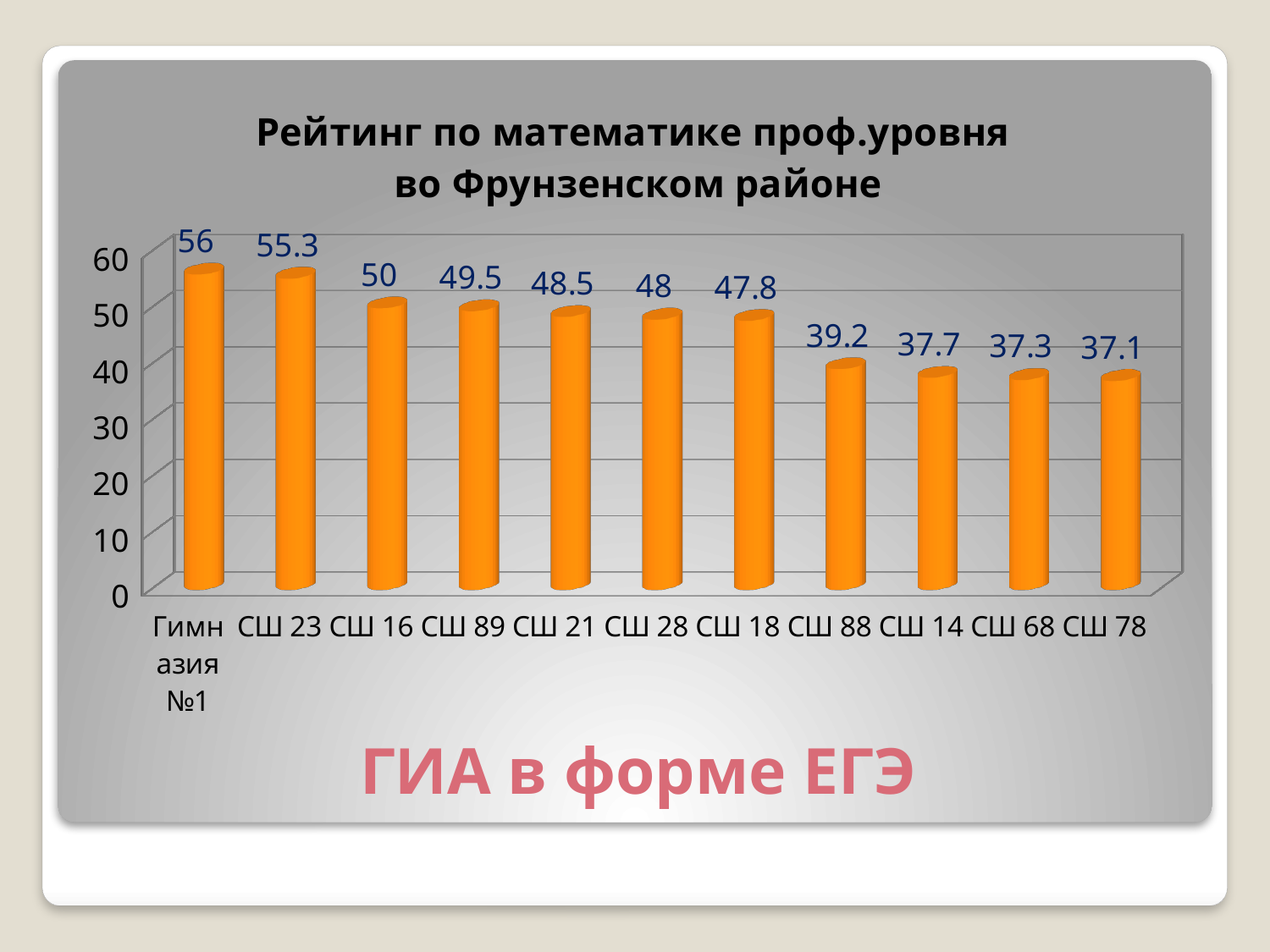
How many categories are shown on the x axis? 11 Do the values rise or fall from left to right along the x axis? fall What is the difference between the values for Гимназия №1 and СШ 78? 18.9 What is the title of the chart? Рейтинг по математике проф.уровня во Фрунзенском районе What is the value for СШ 23? 55.3 What is the value for СШ 88? 39.2 Which category has the lowest value? СШ 78 Which category has the highest value? Гимназия №1 What is the value for СШ 21? 48.5 What kind of chart is this? bar chart What is the difference between the values for СШ 16 and СШ 88? 10.8 Which is larger, the value for СШ 89 or the value for СШ 14? СШ 89